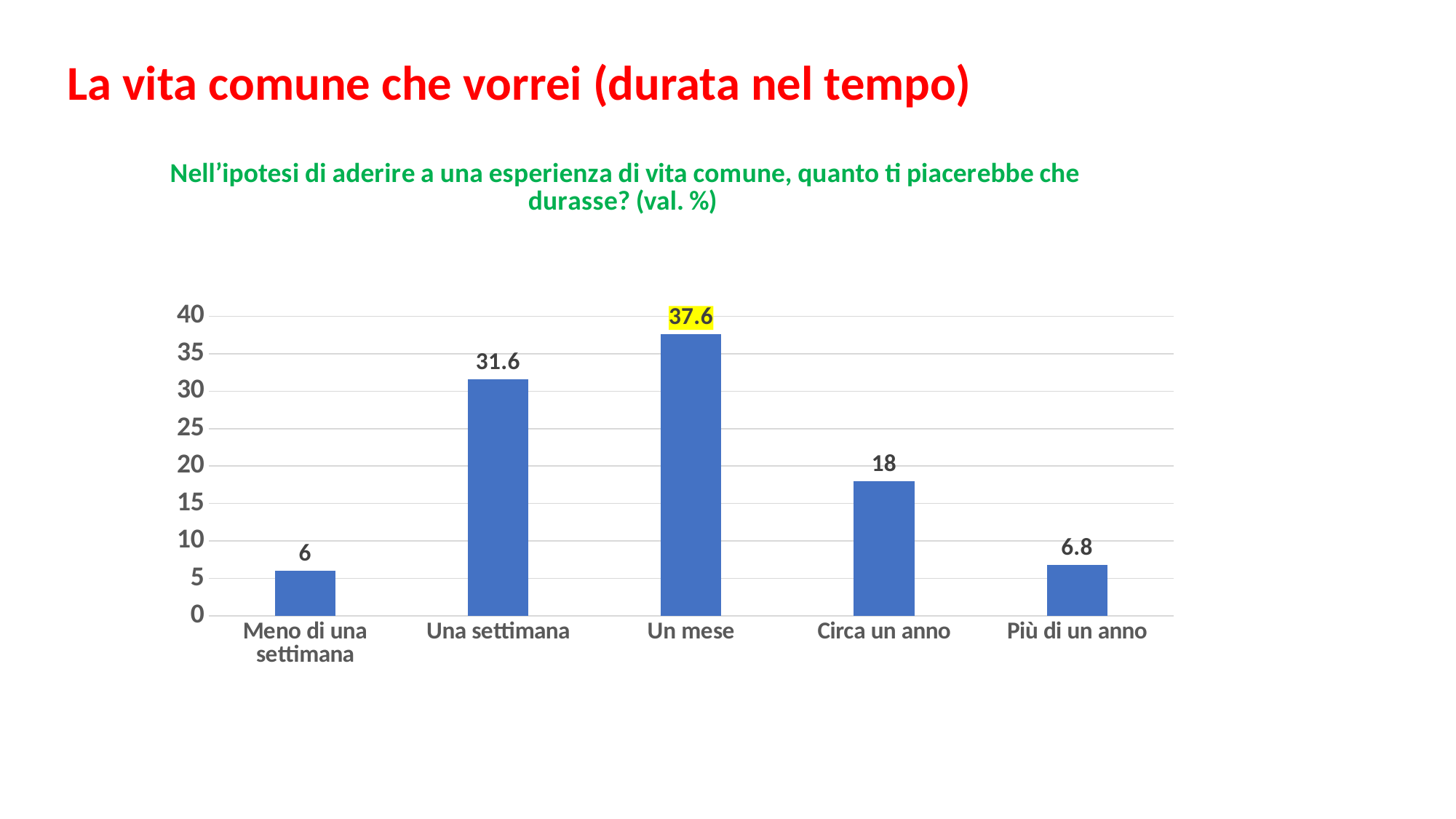
Which category has the lowest value? Meno di una settimana What is the value for "Circa un anno"? 18 What kind of chart is shown on the slide? Bar chart What is the value for "Più di un anno"? 6.8 Which data label is highlighted in yellow? 37.6 Which is larger, the value for "Una settimana" or the value for "Circa un anno"? Una settimana Which category has the highest value? Un mese What is the value for "Un mese"? 37.6 Is the value for "Circa un anno" greater or less than 20? less What is the value for "Meno di una settimana"? 6 How many categories are shown on the x axis? 5 What is the difference between the values for "Un mese" and "Una settimana"? 6